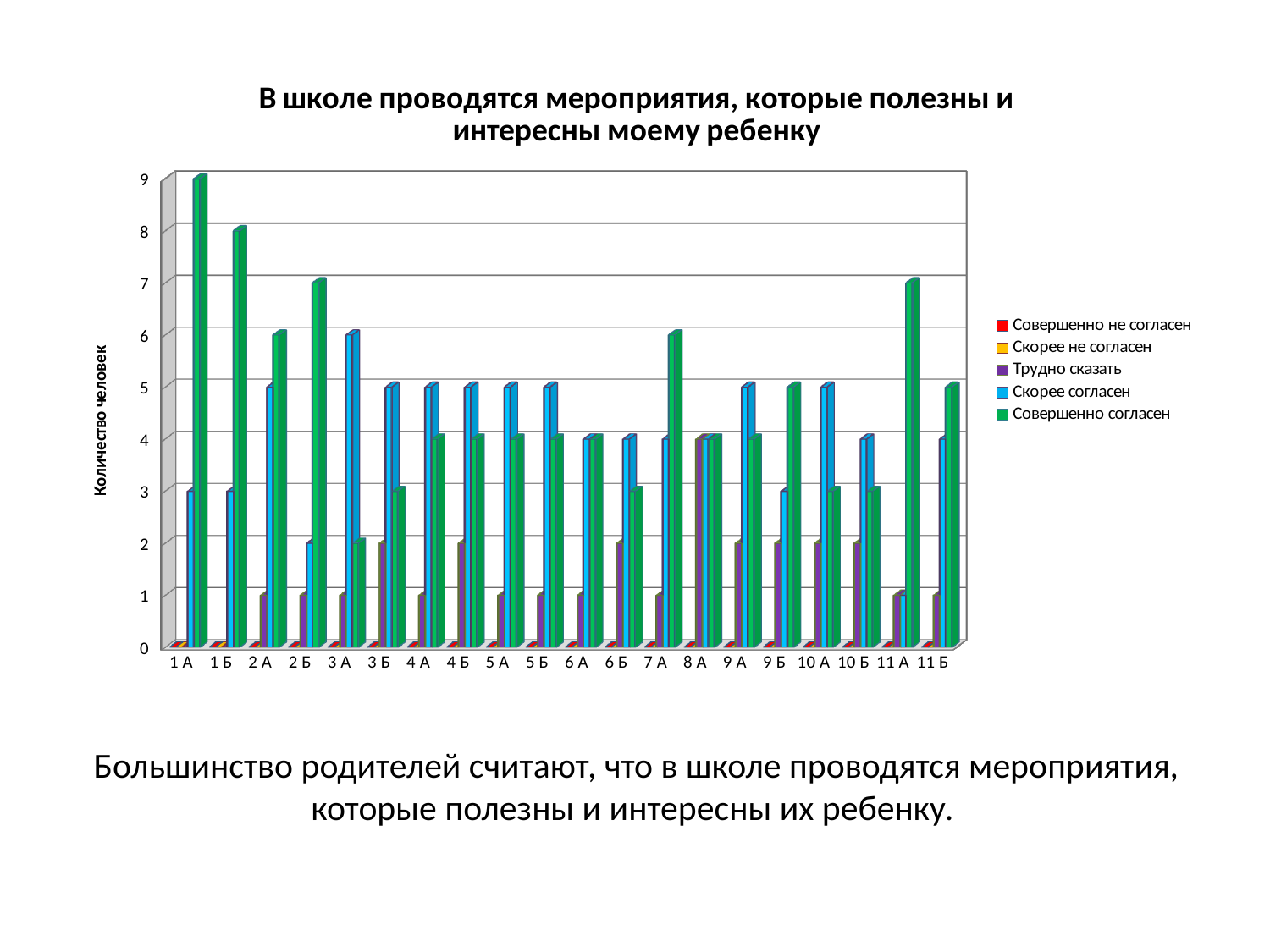
Which class has the highest value for 'Совершенно согласен'? 1 А What kind of chart is shown on the slide? bar chart What is the value for 'Совершенно согласен' for class 1 А? 9 For class 3 А, which is larger: 'Скорее согласен' or 'Совершенно согласен'? Скорее согласен What is the label of the vertical axis? Количество человек For class 2 Б, which is larger: 'Скорее согласен' or 'Совершенно согласен'? Совершенно согласен How many series does the legend list? 5 Is the value for 'Скорее согласен' for class 11 А greater or less than 3? less Is the value for 'Совершенно согласен' for class 1 Б greater or less than 5? greater Which class has the lowest value for 'Совершенно согласен'? 3 А How many class categories are shown on the x axis? 20 What is the title of the chart? В школе проводятся мероприятия, которые полезны и интересны моему ребенку